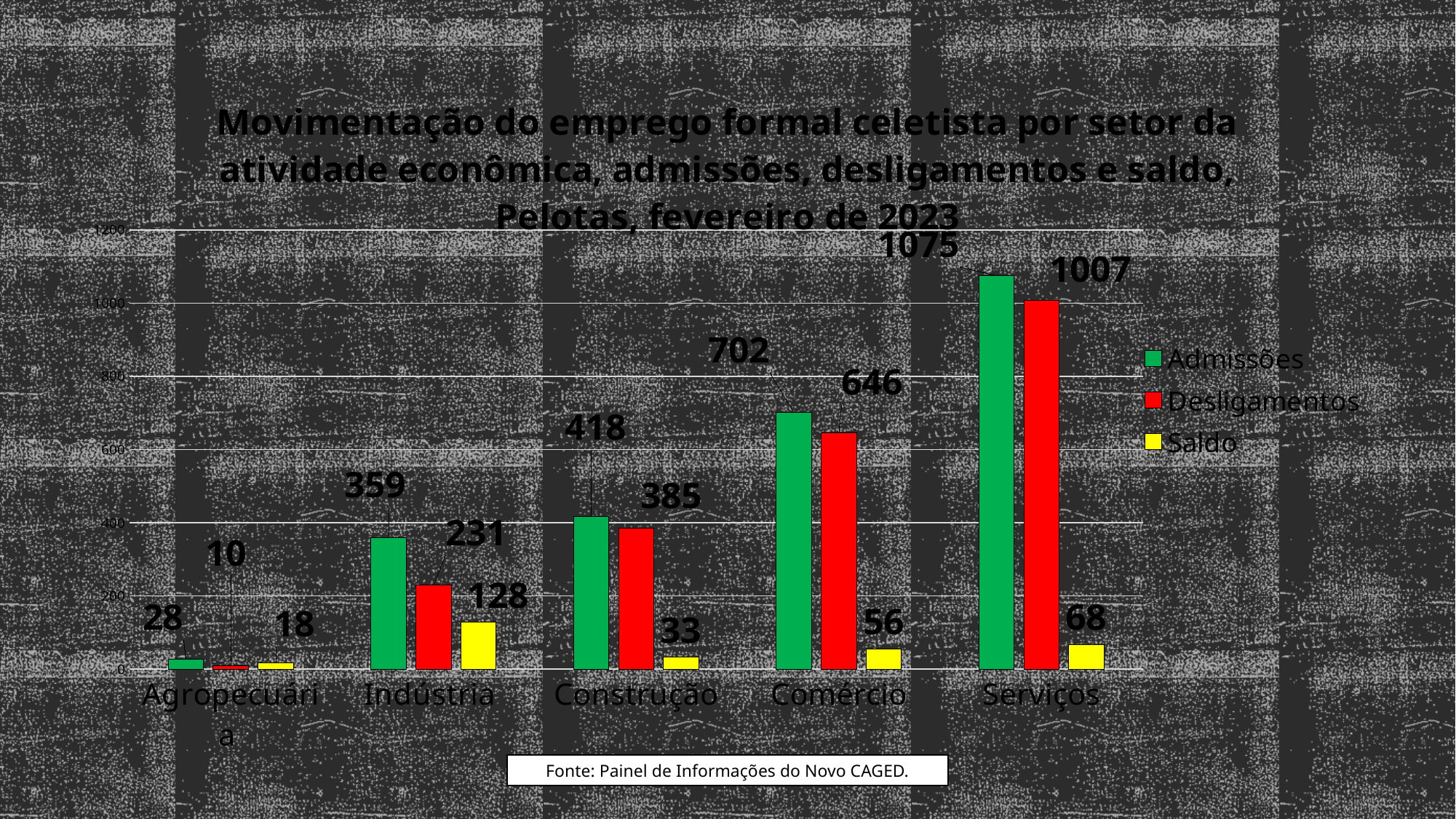
What is the value of Desligamentos for Agropecuária? 10 What kind of chart is shown on the slide? Bar chart What is the value of Desligamentos for Comércio? 646 Which sector has the highest Admissões value? Serviços Which sector has the lowest Saldo value? Agropecuária How many sectors are shown on the x axis? 5 What is the value of Admissões for Serviços? 1075 What is the Saldo value for Indústria? 128 What is the difference between Admissões and Desligamentos for Construção? 33 Which is larger: Admissões for Comércio or Desligamentos for Serviços? Desligamentos for Serviços How many series does the legend list? 3 Which colour represents the Saldo series in the legend? Yellow